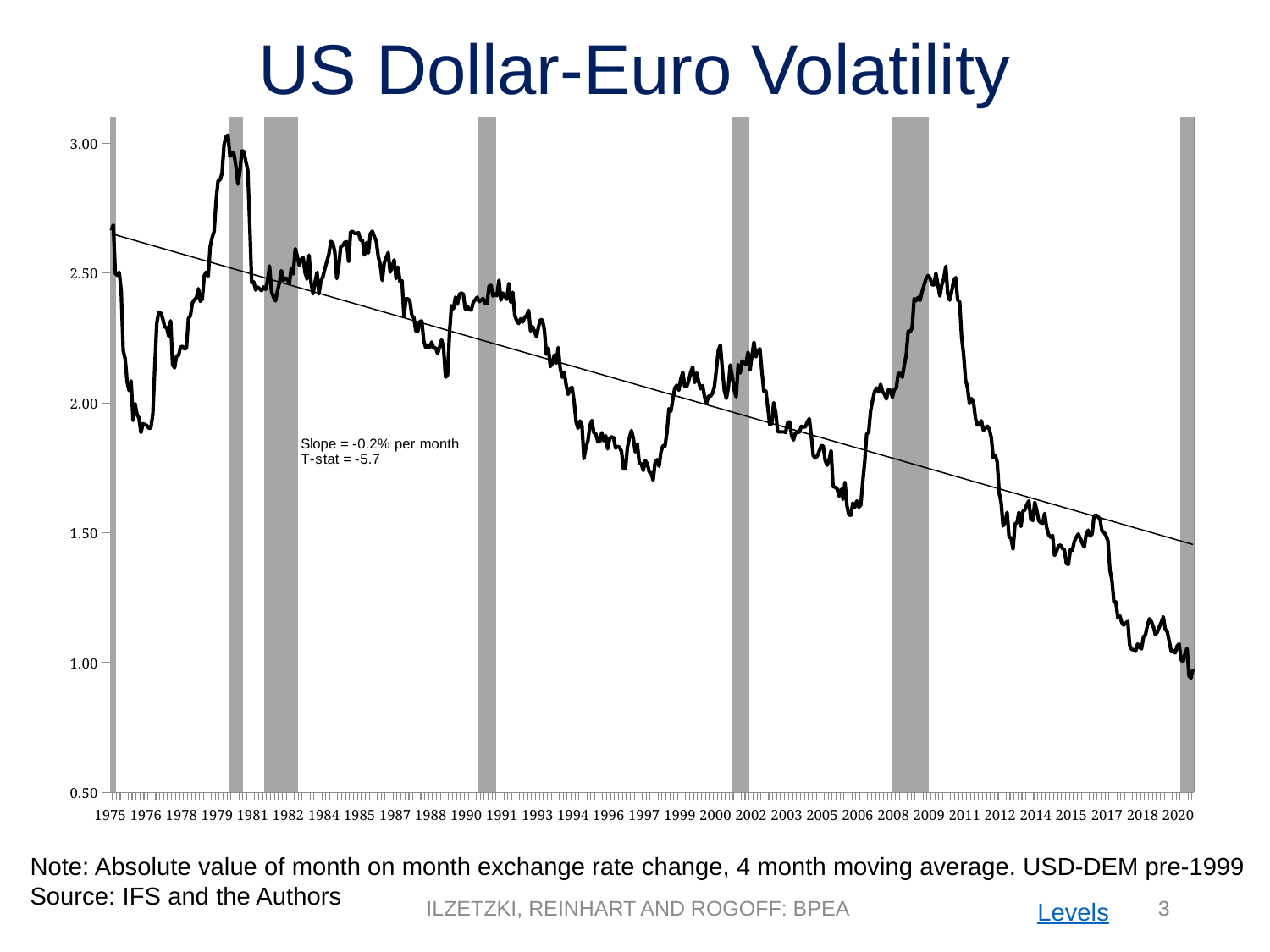
What T-stat is reported in the chart annotation? -5.7 Is the value for the peak around 2009 greater or less than 2.00? greater Is the value for 1985 greater or less than 2.00? greater What kind of chart is shown on the slide? line chart Is the value for 1997 greater or less than 2.00? less Around which year does the volatility series reach its highest peak? 1979 Around which year does the volatility series reach its lowest point? 2020 Is the volatility value around 1979 larger or smaller than the value around 2018? larger Does the volatility series generally rise or fall from 1975 to 2020? fall What slope is reported for the trend line in the chart annotation? -0.2% per month